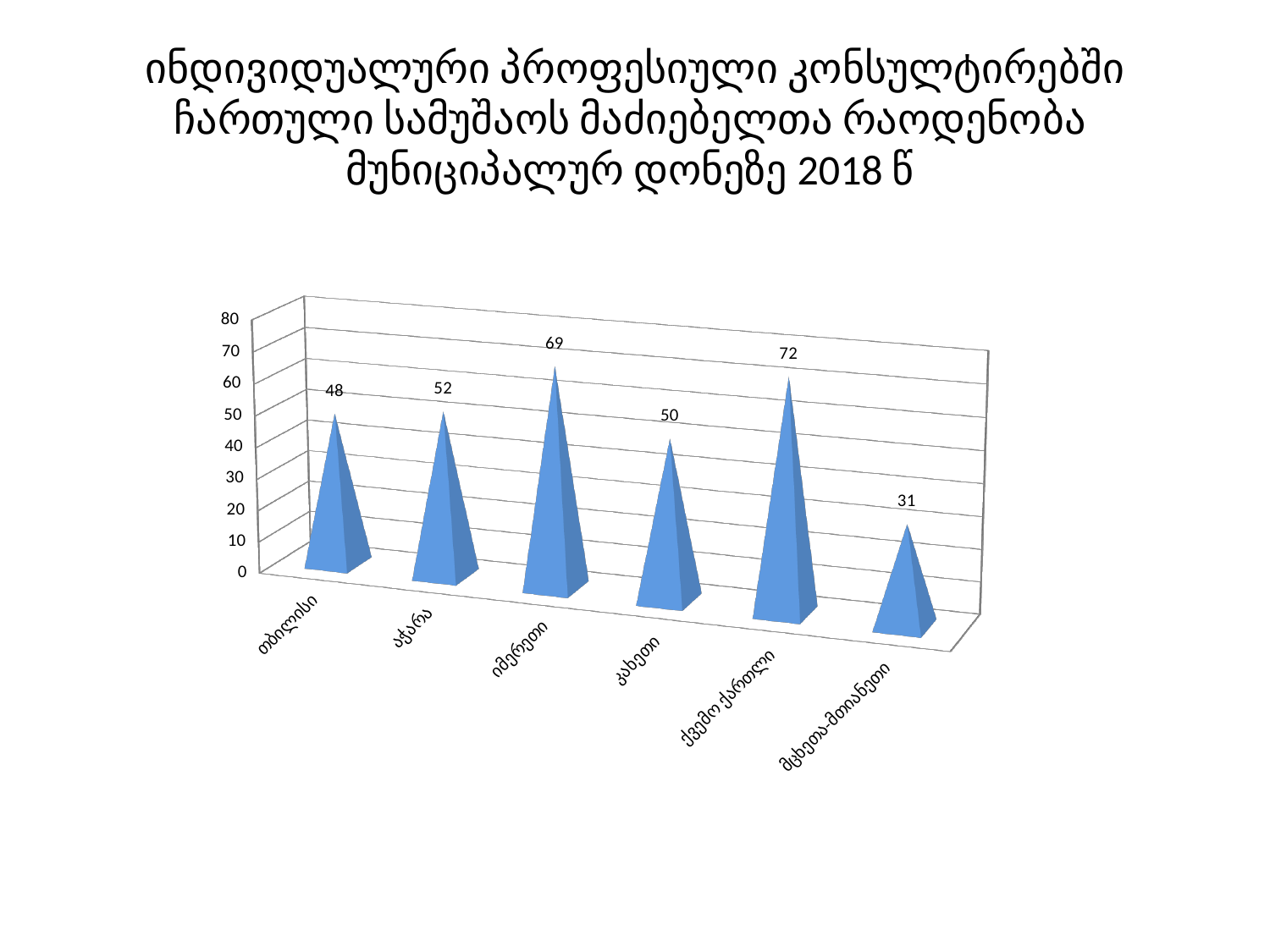
What year is mentioned in the chart title? 2018 How many categories are shown on the x axis? 6 Is the value for იმერეთი greater or less than 60? greater What is the difference between the values for ქვემო ქართლი and მცხეთა-მთიანეთი? 41 What is the value for თბილისი? 48 Which category has the lowest value? მცხეთა-მთიანეთი Which is larger, the value for აჭარა or the value for თბილისი? აჭარა What is the value for ქვემო ქართლი? 72 What is the difference between the values for იმერეთი and კახეთი? 19 Which category has the highest value? ქვემო ქართლი What kind of chart is shown on the slide? bar chart What is the value for მცხეთა-მთიანეთი? 31